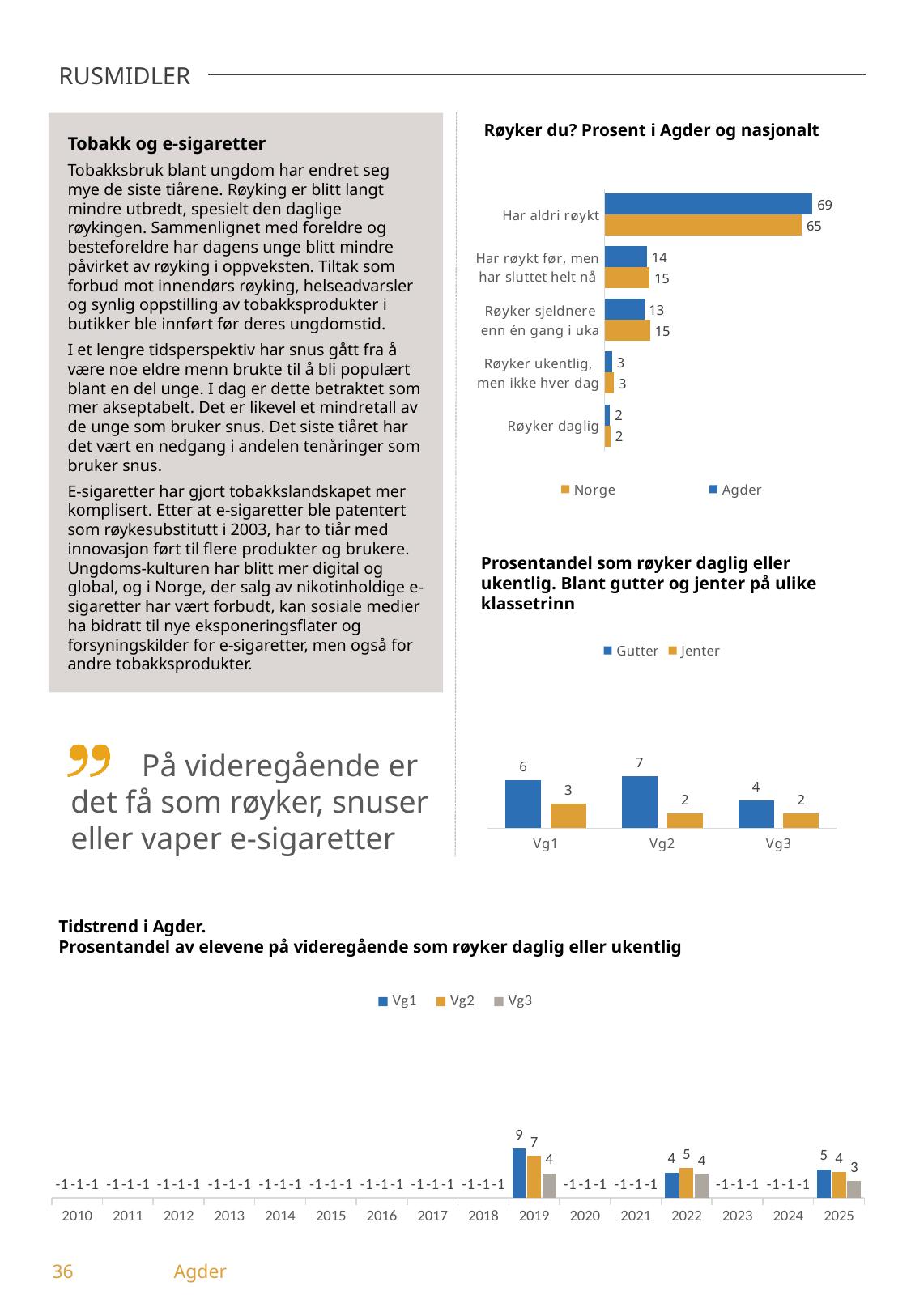
In the chart 'Prosentandel som røyker daglig eller ukentlig', what is the value for Gutter at Vg2? 7 In the chart 'Røyker du? Prosent i Agder og nasjonalt', which category has the highest Agder value? Har aldri røykt In the chart 'Røyker du? Prosent i Agder og nasjonalt', how many series does the legend list? 2 In the chart 'Tidstrend i Agder', what is the Vg3 value for 2025? 3 In the chart 'Røyker du? Prosent i Agder og nasjonalt', what is the difference between the Agder and Norge values for 'Har aldri røykt'? 4 In the chart 'Røyker du? Prosent i Agder og nasjonalt', what is the Norge value for 'Røyker sjeldnere enn én gang i uka'? 15 In the chart 'Røyker du? Prosent i Agder og nasjonalt', what is the Agder value for 'Har aldri røykt'? 69 In the chart 'Tidstrend i Agder', what is the Vg1 value for 2019? 9 In the chart 'Prosentandel som røyker daglig eller ukentlig', how many class levels are shown on the x axis? 3 What kind of chart is 'Tidstrend i Agder'? Bar chart In the chart 'Prosentandel som røyker daglig eller ukentlig', what is the difference between Gutter and Jenter at Vg2? 5 In the chart 'Prosentandel som røyker daglig eller ukentlig', which is larger at Vg1: Gutter or Jenter? Gutter